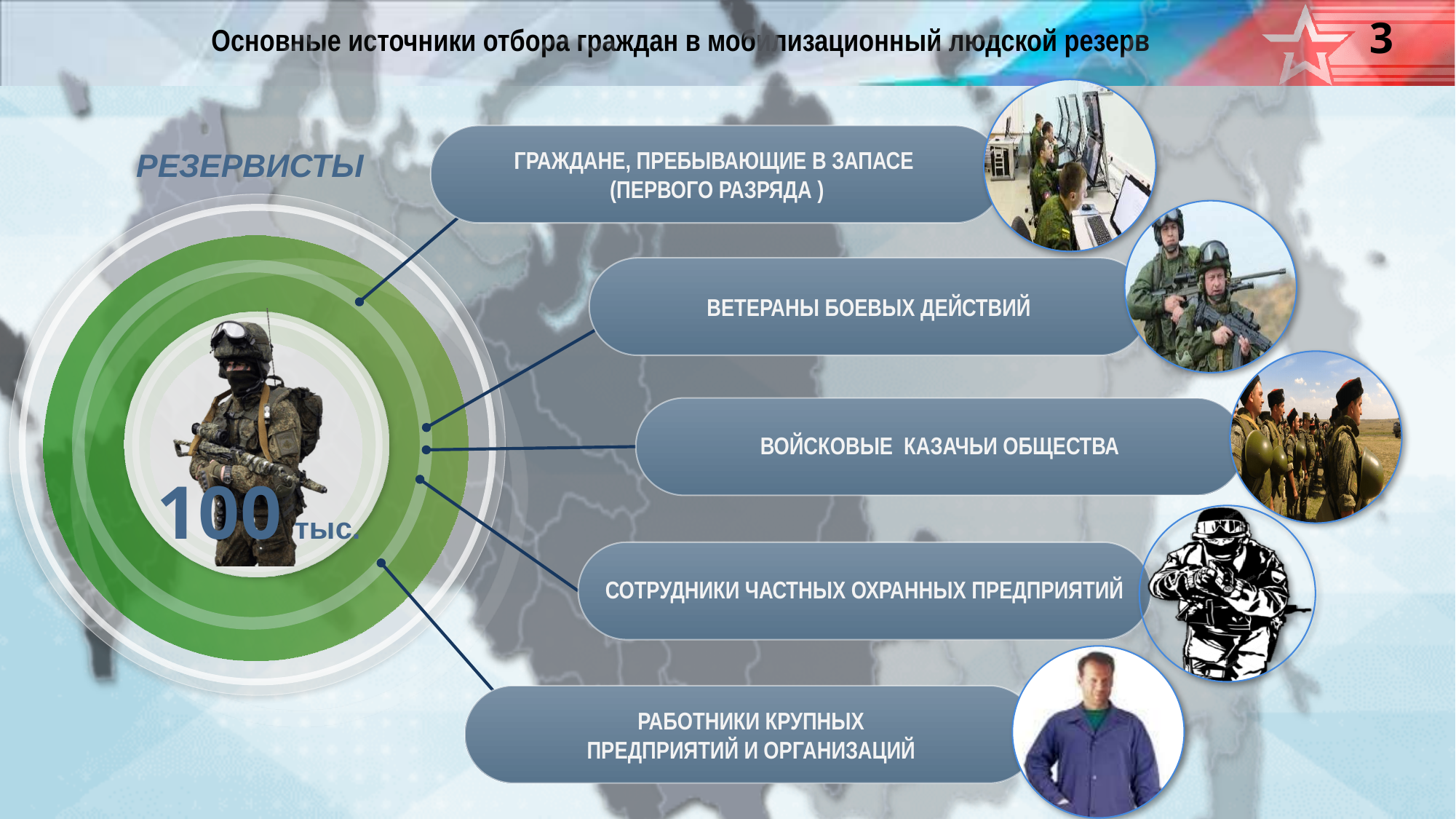
What label appears above the circular diagram on the left? РЕЗЕРВИСТЫ Which source is listed third in the diagram? ВОЙСКОВЫЕ КАЗАЧЬИ ОБЩЕСТВА What number is shown in the centre of the circular diagram? 100 тыс. What is the title of the slide? Основные источники отбора граждан в мобилизационный людской резерв Which source is listed last (at the bottom) in the diagram? РАБОТНИКИ КРУПНЫХ ПРЕДПРИЯТИЙ И ОРГАНИЗАЦИЙ How many sources of selection are listed in the diagram? 5 Which source is listed first (at the top) in the diagram? ГРАЖДАНЕ, ПРЕБЫВАЮЩИЕ В ЗАПАСЕ (ПЕРВОГО РАЗРЯДА)